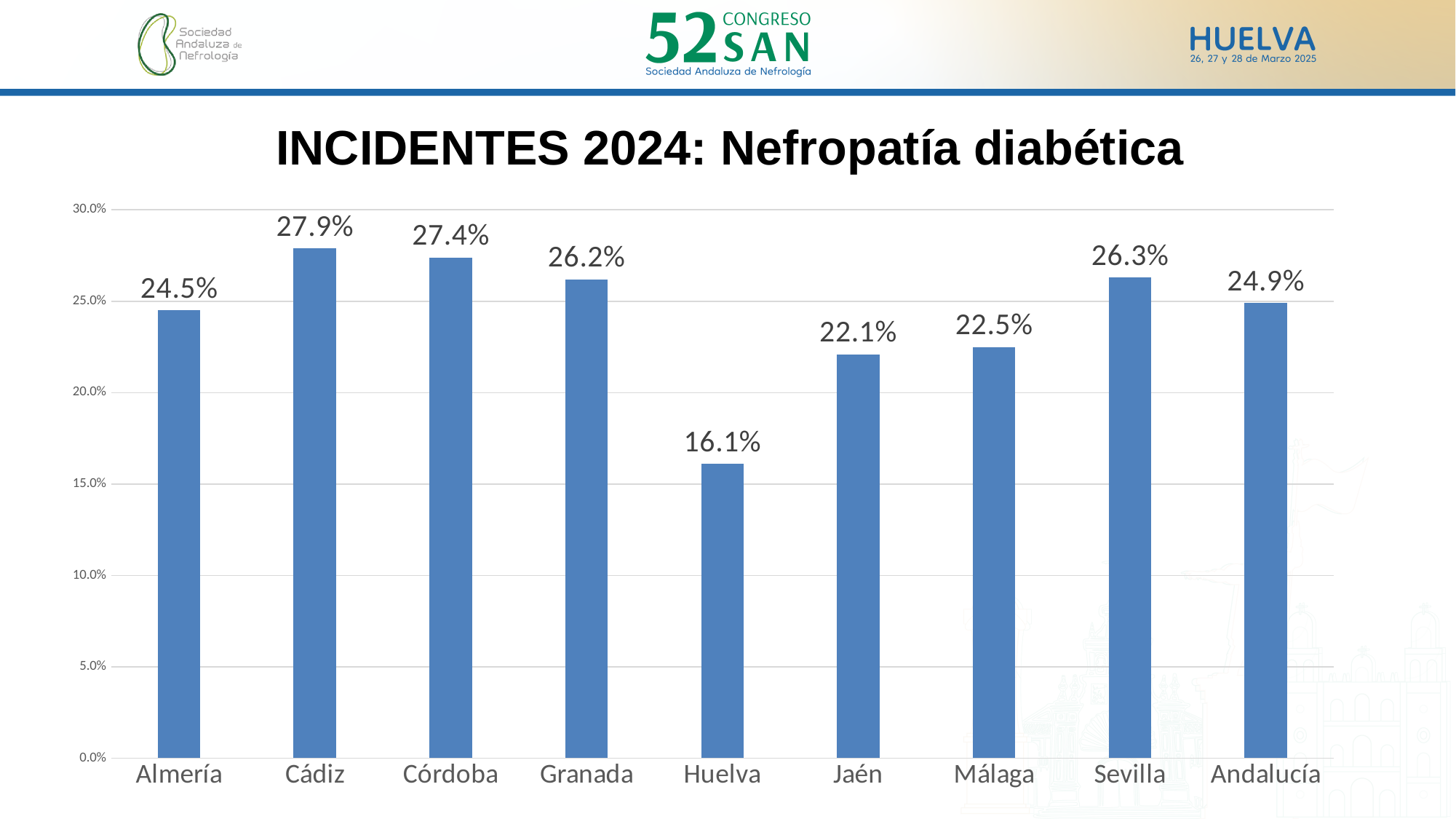
What is the value for Huelva? 16.1% What is the value for Cádiz? 27.9% What is the difference between the values for Sevilla and Granada? 0.1% Which category has the lowest value? Huelva Which category has the highest value? Cádiz How many categories are shown on the x axis? 9 What kind of chart is shown on the slide? bar chart Is the value for Huelva greater or less than 20.0%? less Which is larger, the value for Málaga or the value for Jaén? Málaga What is the title of the chart? INCIDENTES 2024: Nefropatía diabética What is the difference between the values for Cádiz and Huelva? 11.8% What is the value for Andalucía? 24.9%